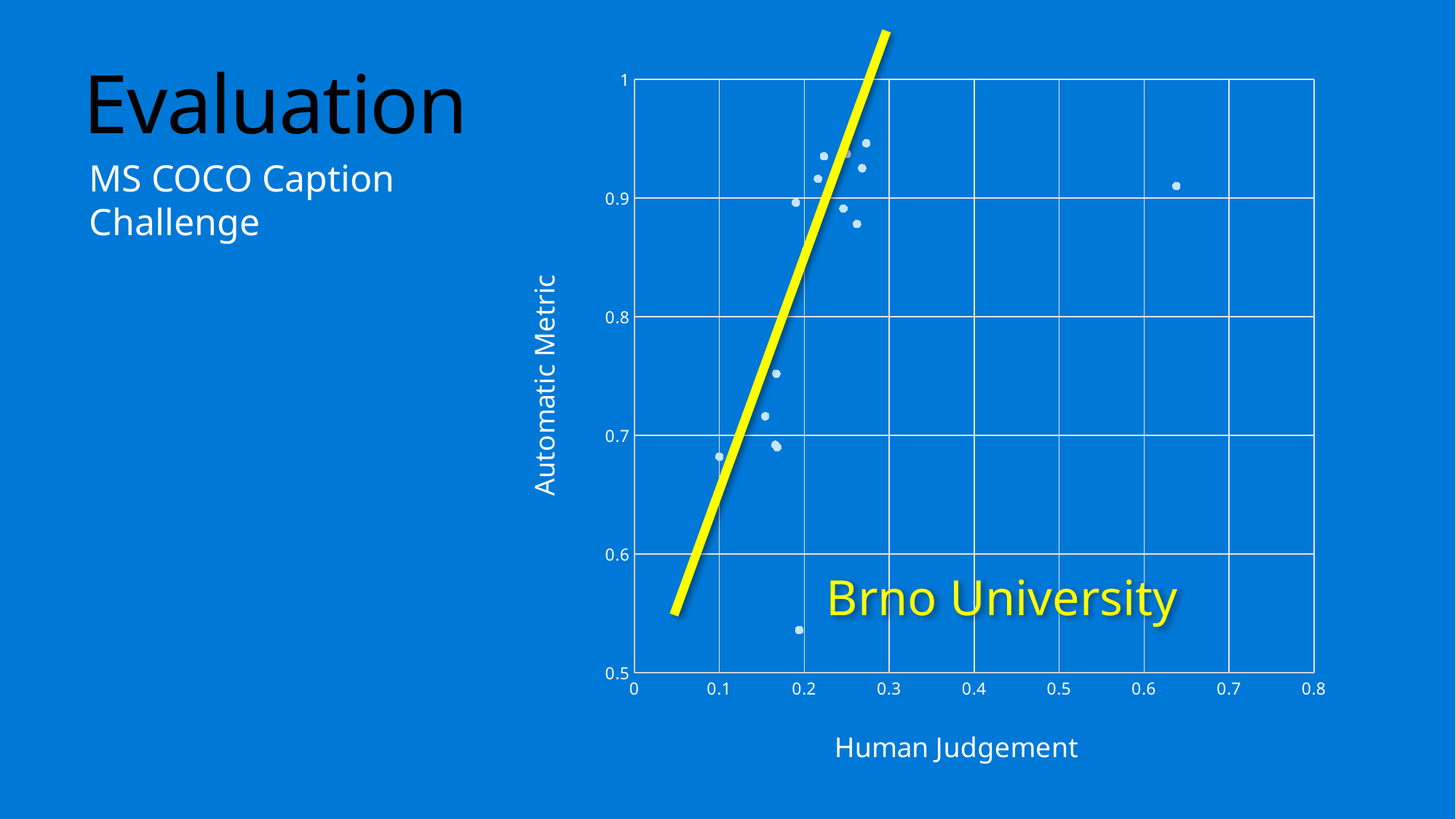
Is the Human Judgement value of the rightmost point on the chart greater or less than 0.7? less What is the title of the horizontal axis of the chart? Human Judgement Is the Human Judgement value of the rightmost point on the chart greater or less than 0.6? greater Is the Automatic Metric value of the highest point on the chart greater or less than 0.9? greater What kind of chart is shown on the slide? scatter chart Do the Automatic Metric values generally rise or fall as Human Judgement increases along the x axis? rise What is the title of the vertical axis of the chart? Automatic Metric